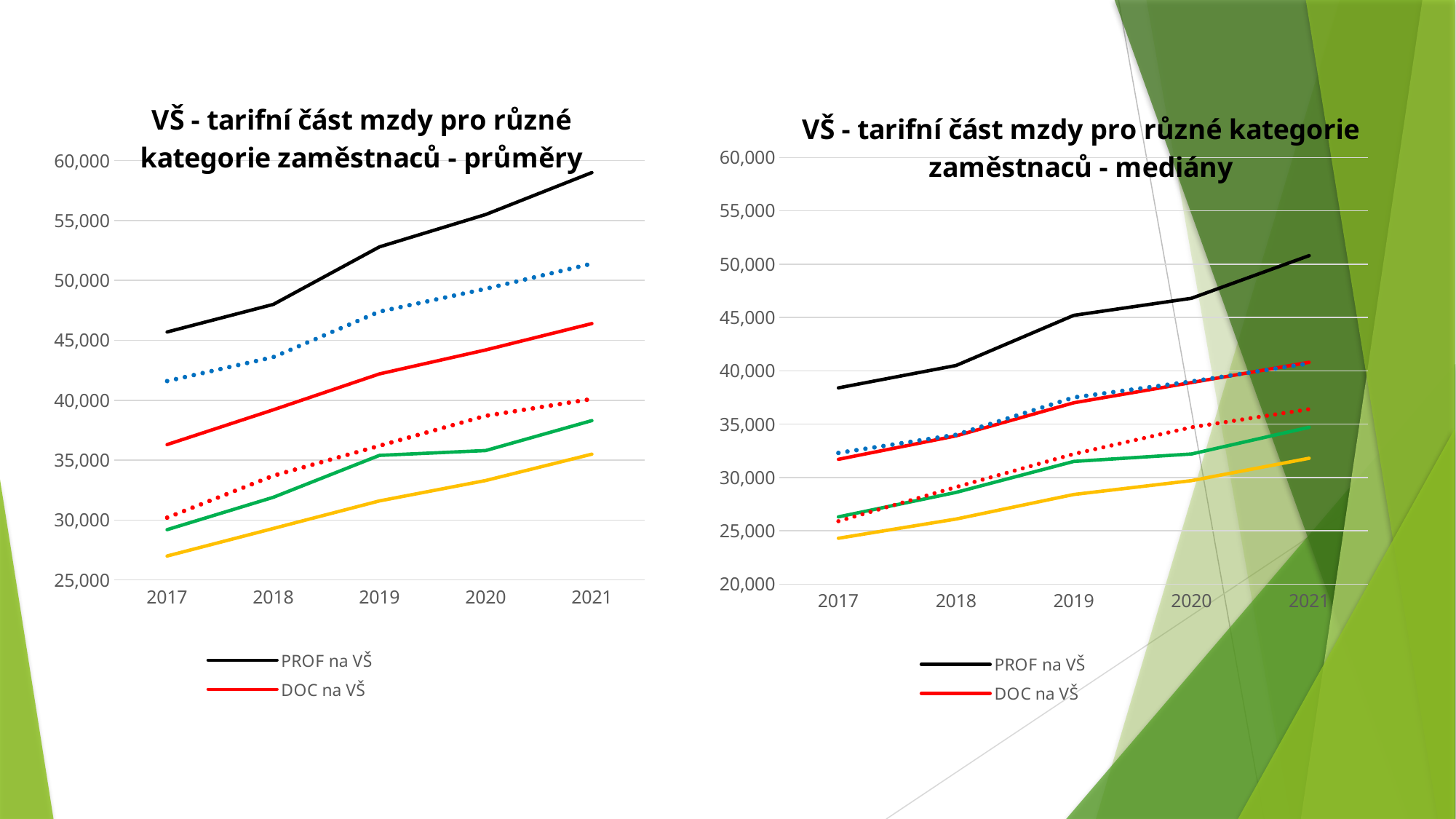
In the left chart ('průměry'), which is larger in 2021, PROF na VŠ or DOC na VŠ? PROF na VŠ In the left chart ('průměry'), is the value for PROF na VŠ in 2021 greater or less than 55,000? greater In the right chart ('mediány'), is the value for PROF na VŠ in 2020 greater or less than 45,000? greater In the left chart ('průměry'), does the PROF na VŠ line rise or fall from 2017 to 2021? rise What colour is the PROF na VŠ line in the left chart ('průměry')? black How many years are shown on the x axis of the left chart ('průměry')? 5 In the right chart ('mediány'), is the value for DOC na VŠ in 2017 greater or less than 30,000? greater How many series does the legend of the right chart ('mediány') list? 2 In the right chart ('mediány'), does the DOC na VŠ line rise or fall from 2017 to 2021? rise What kind of chart is the left chart titled 'VŠ - tarifní část mzdy pro různé kategorie zaměstnaců - průměry'? line chart